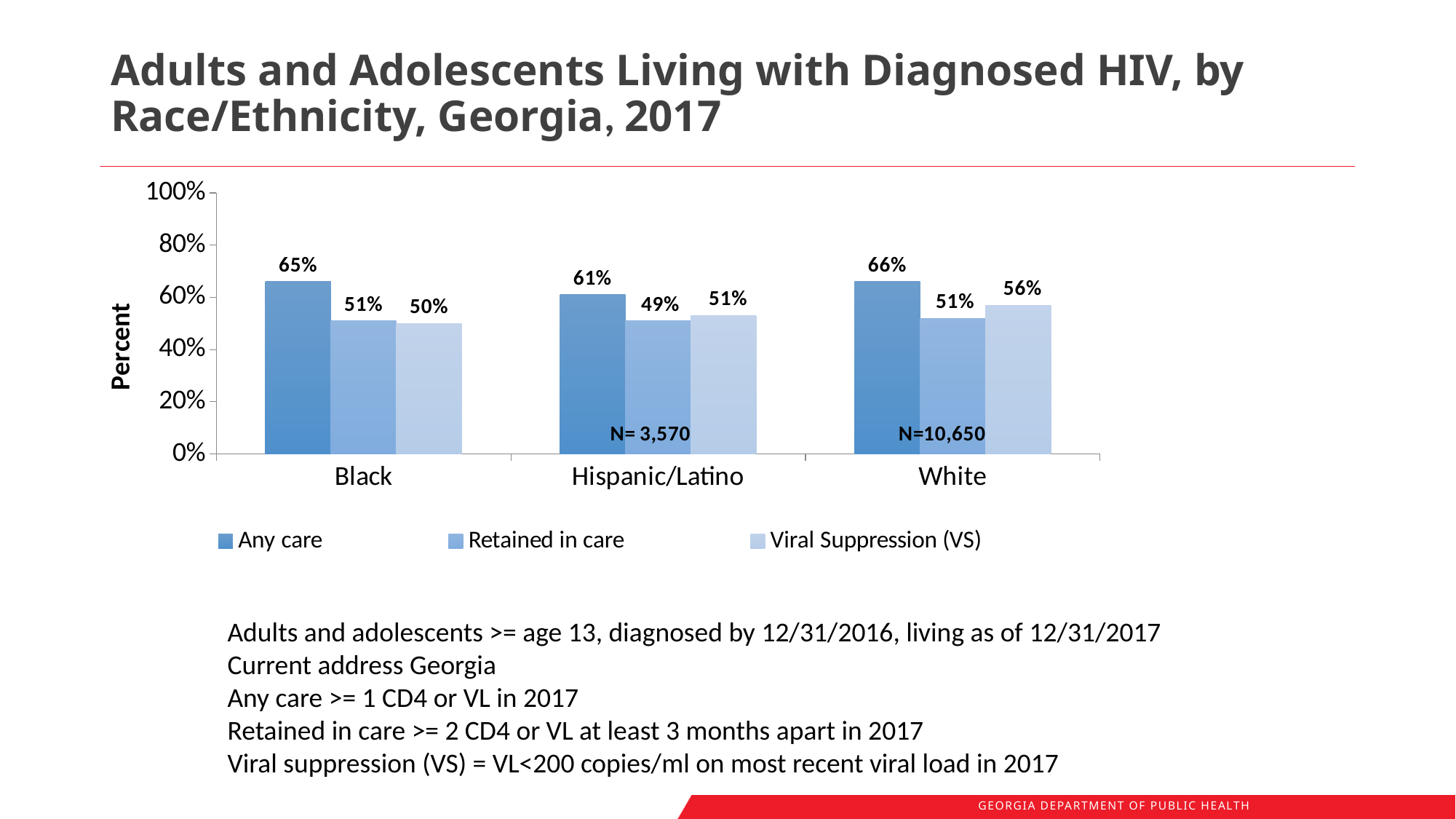
Is the Any care value for White larger or smaller than the Any care value for Hispanic/Latino? larger What is the Retained in care value for Hispanic/Latino? 49% What is the difference between the Viral Suppression (VS) values for White and Hispanic/Latino? 5% How many series does the legend list? 3 How many race/ethnicity categories are shown on the x axis? 3 What kind of chart is shown on the slide? bar chart Which race/ethnicity group has the highest Viral Suppression (VS) value? White What is the Any care value for Black? 65% Which race/ethnicity group has the lowest Any care value? Hispanic/Latino What is the difference between the Any care and Viral Suppression (VS) values for Black? 15% What is the Viral Suppression (VS) value for White? 56% What is the label on the y axis? Percent